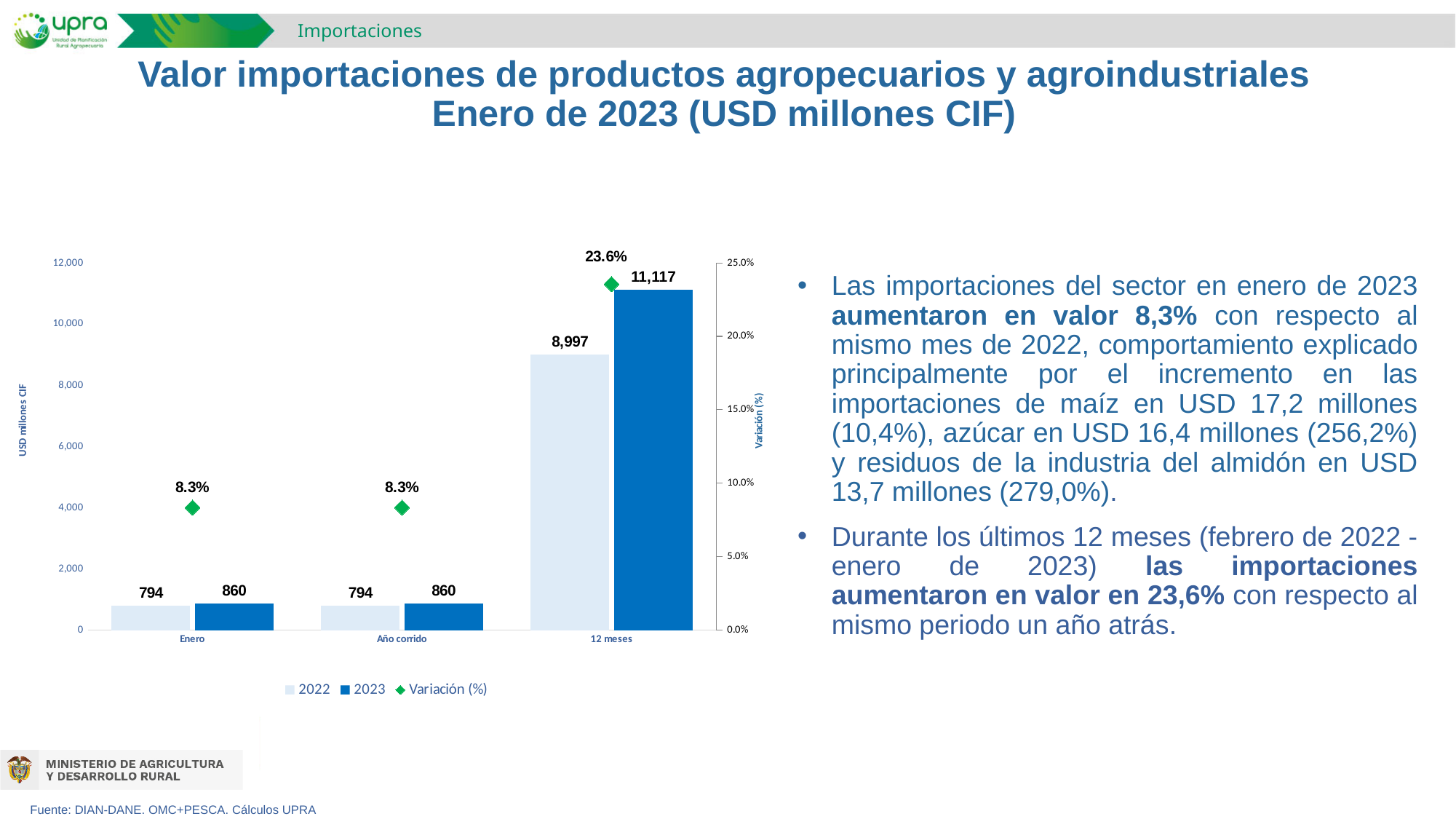
Which is larger for the 12 meses category, the 2022 value or the 2023 value? 2023 What is the difference between the 2023 and 2022 values for the 12 meses category? 2,120 What is the 2023 value for the 12 meses category? 11,117 What is the 2022 value for the Enero category? 794 What is the difference between the 2023 and 2022 values for the Enero category? 66 How many series does the legend list? 3 What kind of chart is used to show the 2022 and 2023 values? Bar chart Which category has the highest 2023 value? 12 meses What is the Variación (%) value for the Año corrido category? 8.3% What is the label of the left vertical axis? USD millones CIF How many categories are shown on the x axis? 3 What is the Variación (%) value for the 12 meses category? 23.6%